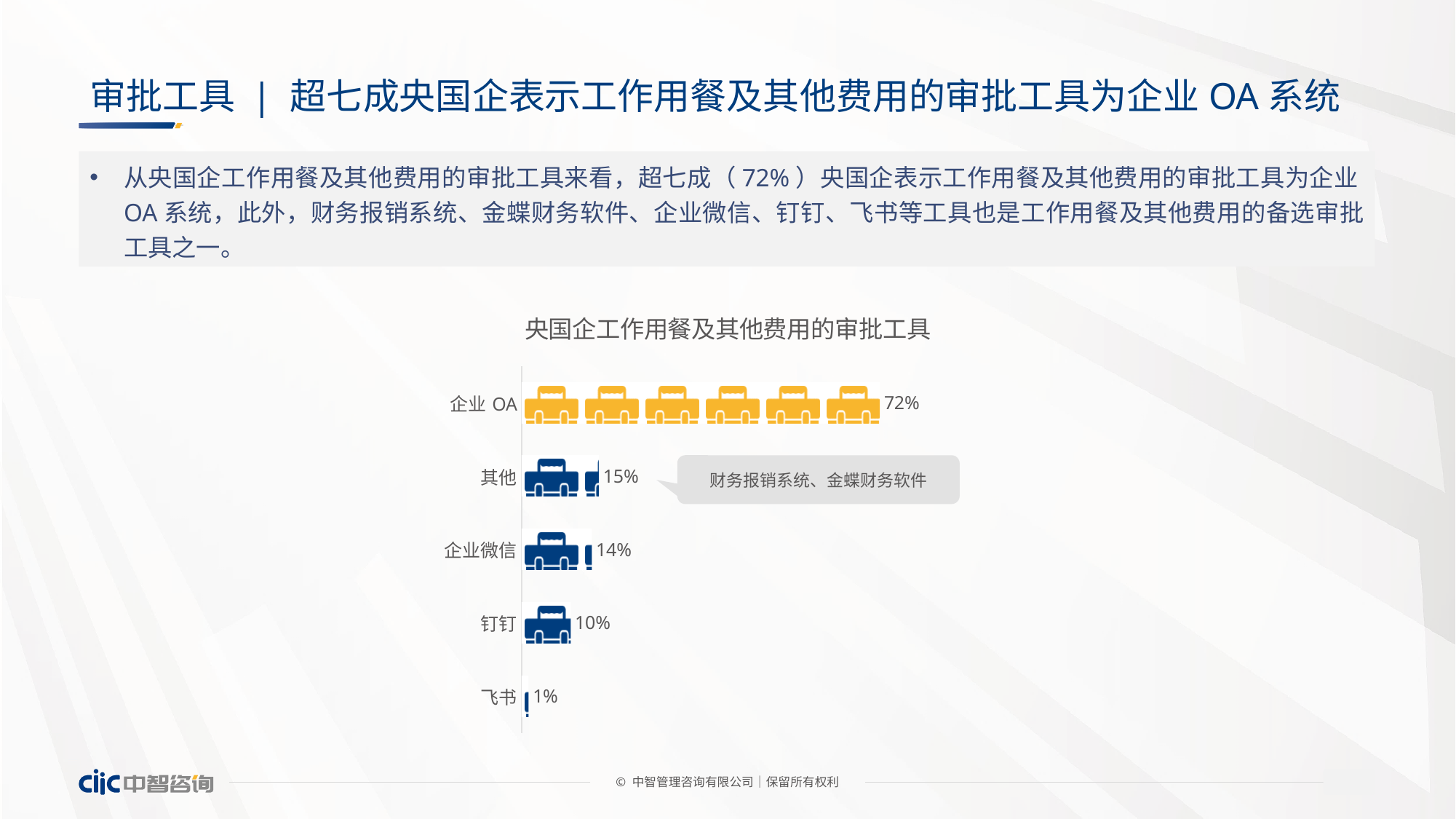
What is the title of the chart? 央国企工作用餐及其他费用的审批工具 What is the difference between the values for 企业 OA and 其他? 57% Which category has the lowest value? 飞书 What is the difference between the values for 企业微信 and 钉钉? 4% What is the value for 钉钉? 10% What kind of chart is shown on the slide? Bar chart How many categories are shown in the chart? 5 What is the value for 企业微信? 14% What is the value for 飞书? 1% Which is larger, the value for 其他 or the value for 钉钉? 其他 What is the value for 企业 OA? 72% Which category has the highest value? 企业 OA